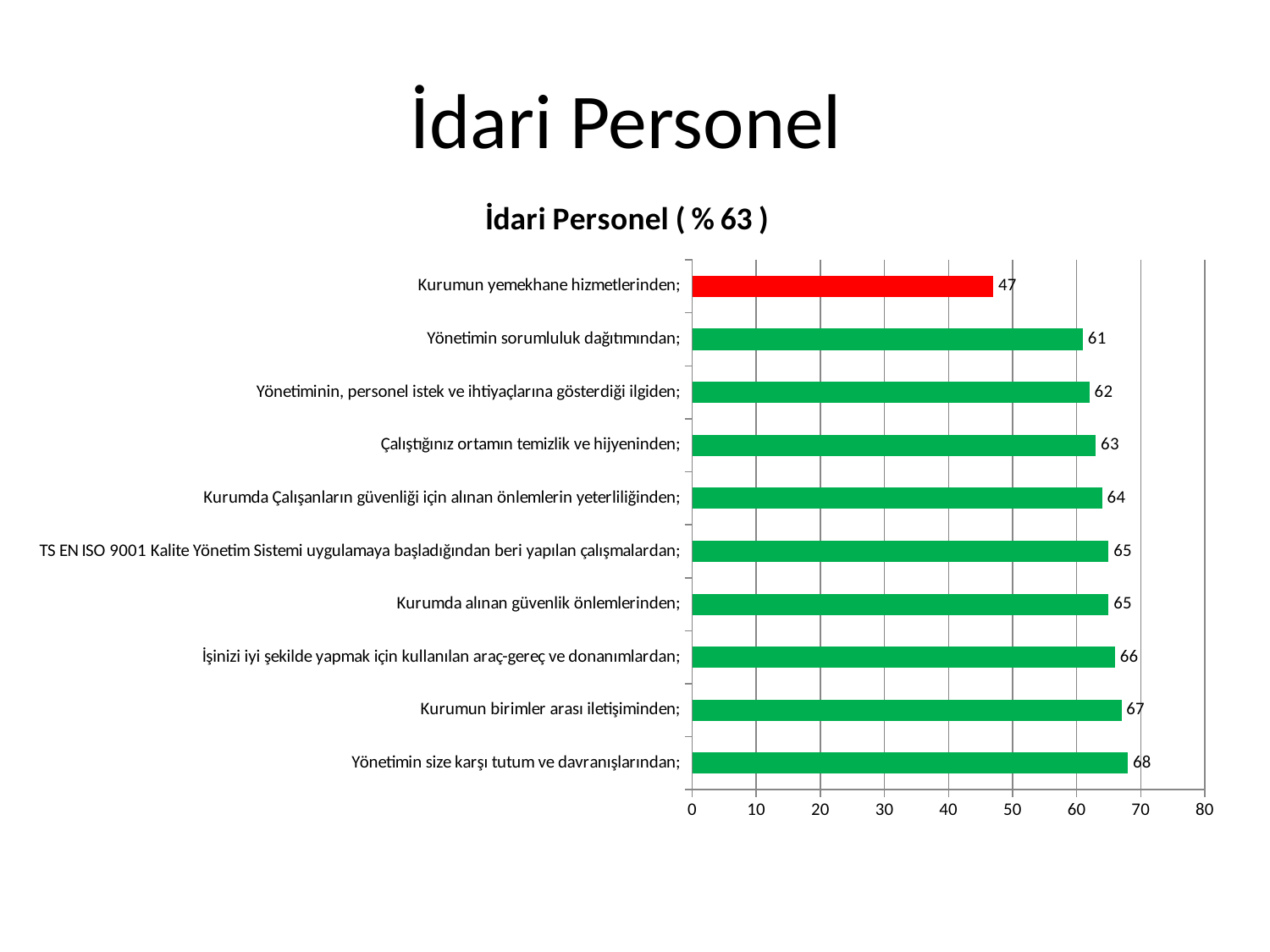
What is the value for "Çalıştığınız ortamın temizlik ve hijyeninden;"? 63 How many categories are shown in the chart? 10 Which is larger: the value for "Kurumun birimler arası iletişiminden;" or the value for "Yönetimin sorumluluk dağıtımından;"? Kurumun birimler arası iletişiminden; What is the value for "Kurumun yemekhane hizmetlerinden;"? 47 What is the title of the chart? İdari Personel ( % 63 ) What is the difference between the values for "Yönetimin size karşı tutum ve davranışlarından;" and "Kurumun yemekhane hizmetlerinden;"? 21 What is the value for "Yönetimin size karşı tutum ve davranışlarından;"? 68 Is the value for "Kurumun yemekhane hizmetlerinden;" greater or less than 50? less What kind of chart is shown on the slide? bar chart Which category has the highest value? Yönetimin size karşı tutum ve davranışlarından; Which category has the lowest value? Kurumun yemekhane hizmetlerinden; Which bar is coloured red rather than green? Kurumun yemekhane hizmetlerinden;